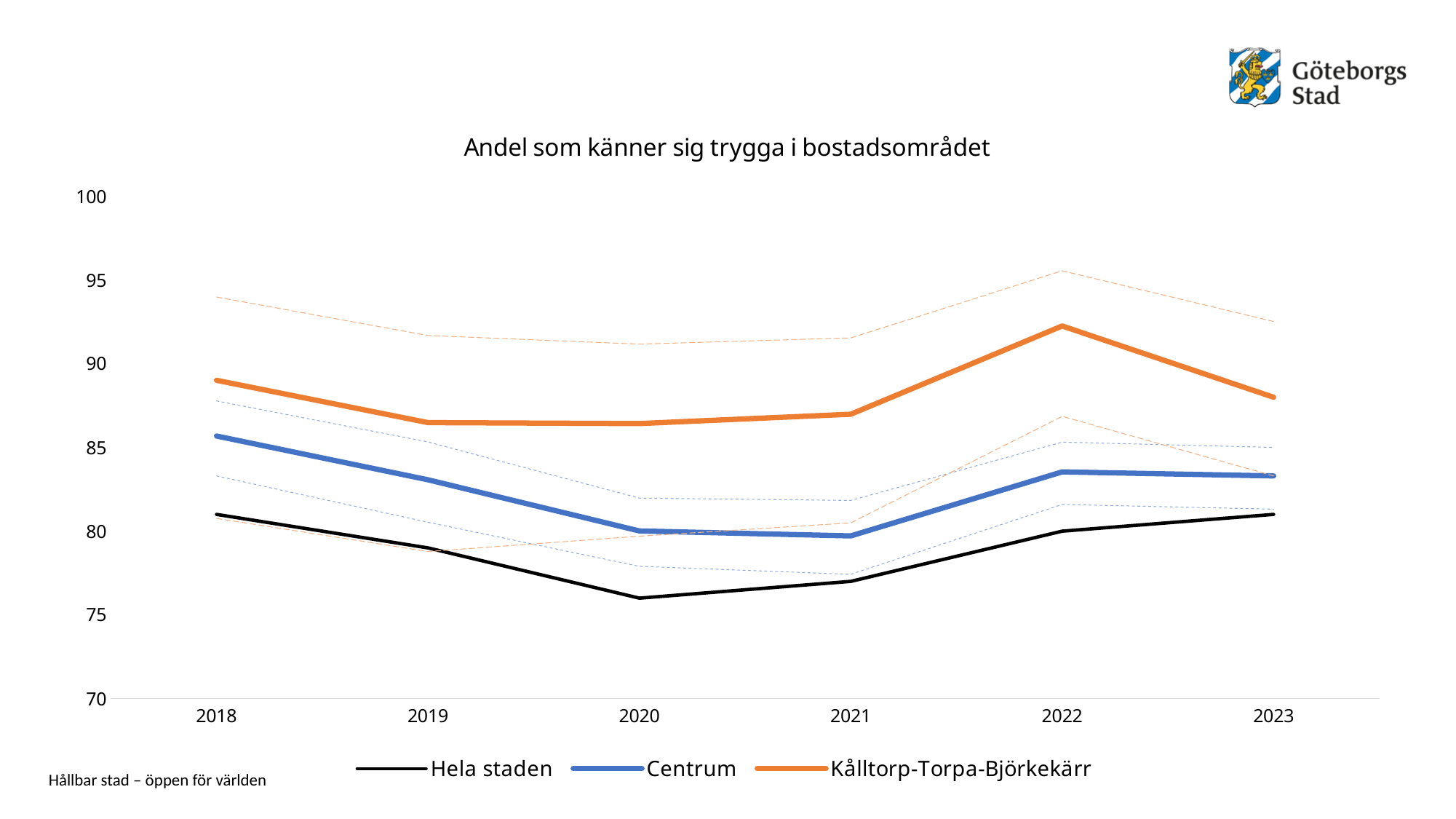
Is the value for Hela staden in 2020 greater or less than 80? less Is the value for Kålltorp-Torpa-Björkekärr in 2022 greater or less than 90? greater How many years are shown on the x axis? 6 How many series does the legend list? 3 In which year does Kålltorp-Torpa-Björkekärr reach its highest value? 2022 Which series is drawn in orange? Kålltorp-Torpa-Björkekärr In which year does Hela staden have its lowest value? 2020 What kind of chart is shown on the slide? Line chart Does the value for Hela staden rise or fall from 2018 to 2020? fall Which series has the highest value in 2023? Kålltorp-Torpa-Björkekärr What is the title of the chart? Andel som känner sig trygga i bostadsområdet Is the value for Kålltorp-Torpa-Björkekärr in 2023 greater or less than 90? less